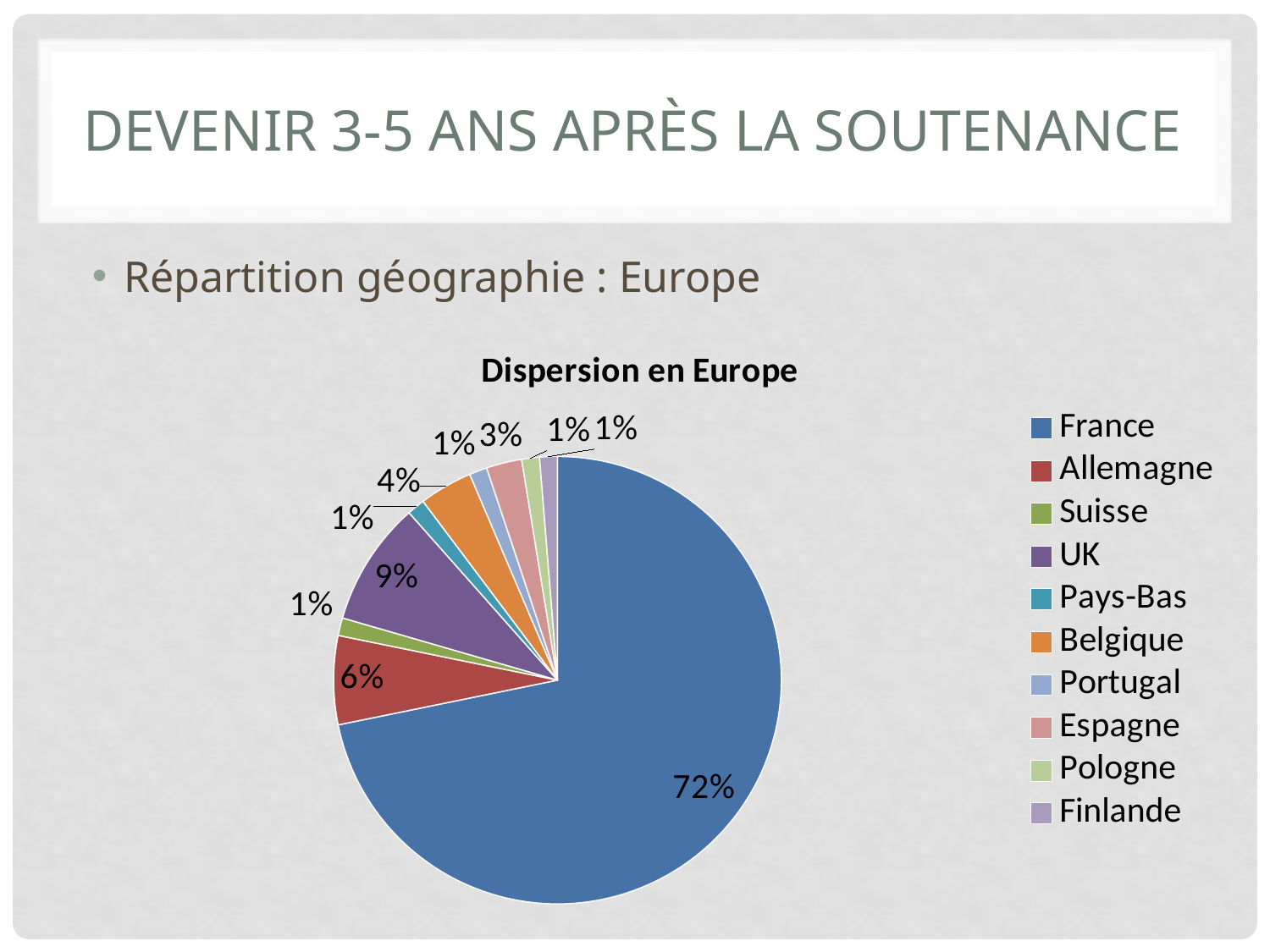
What is the difference between the share for France and the share for UK? 63% What share of the pie does Belgique represent? 4% What type of chart is shown on the slide? pie chart Which is larger, the share for UK or the share for Allemagne? UK What colour is the slice for France? blue What share of the pie does Espagne represent? 3% What share of the pie does Allemagne represent? 6% How many categories does the legend list? 10 Which country has the largest share of the pie? France What is the title of the chart? Dispersion en Europe